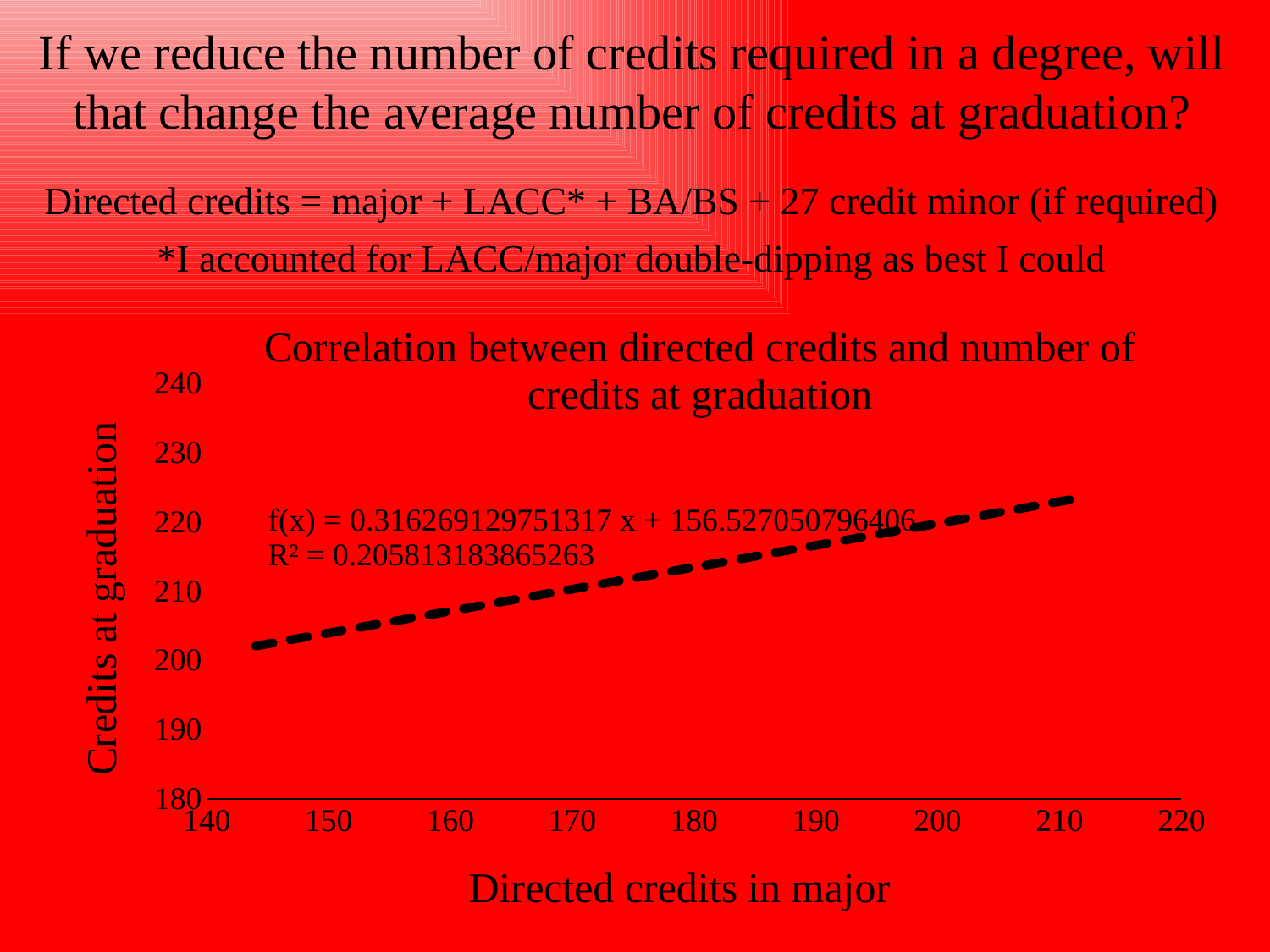
What is the intercept of the trendline shown on the chart? 156.527050796406 What is the label of the x axis of the chart? Directed credits in major What is the title of the chart? Correlation between directed credits and number of credits at graduation Does the trendline rise or fall as directed credits in major increase? rise What is the highest value shown on the y axis of the chart? 240 What is the lowest value shown on the x axis of the chart? 140 Is the trendline value at 190 directed credits greater or less than 210 credits at graduation? greater What is the R² value printed on the chart? 0.205813183865263 What is the trendline equation printed on the chart? f(x) = 0.316269129751317 x + 156.527050796406 Is the trendline value at 150 directed credits greater or less than 200 credits at graduation? greater Is the trendline value at 170 directed credits greater or less than 220 credits at graduation? less What is the slope of the trendline shown on the chart? 0.316269129751317